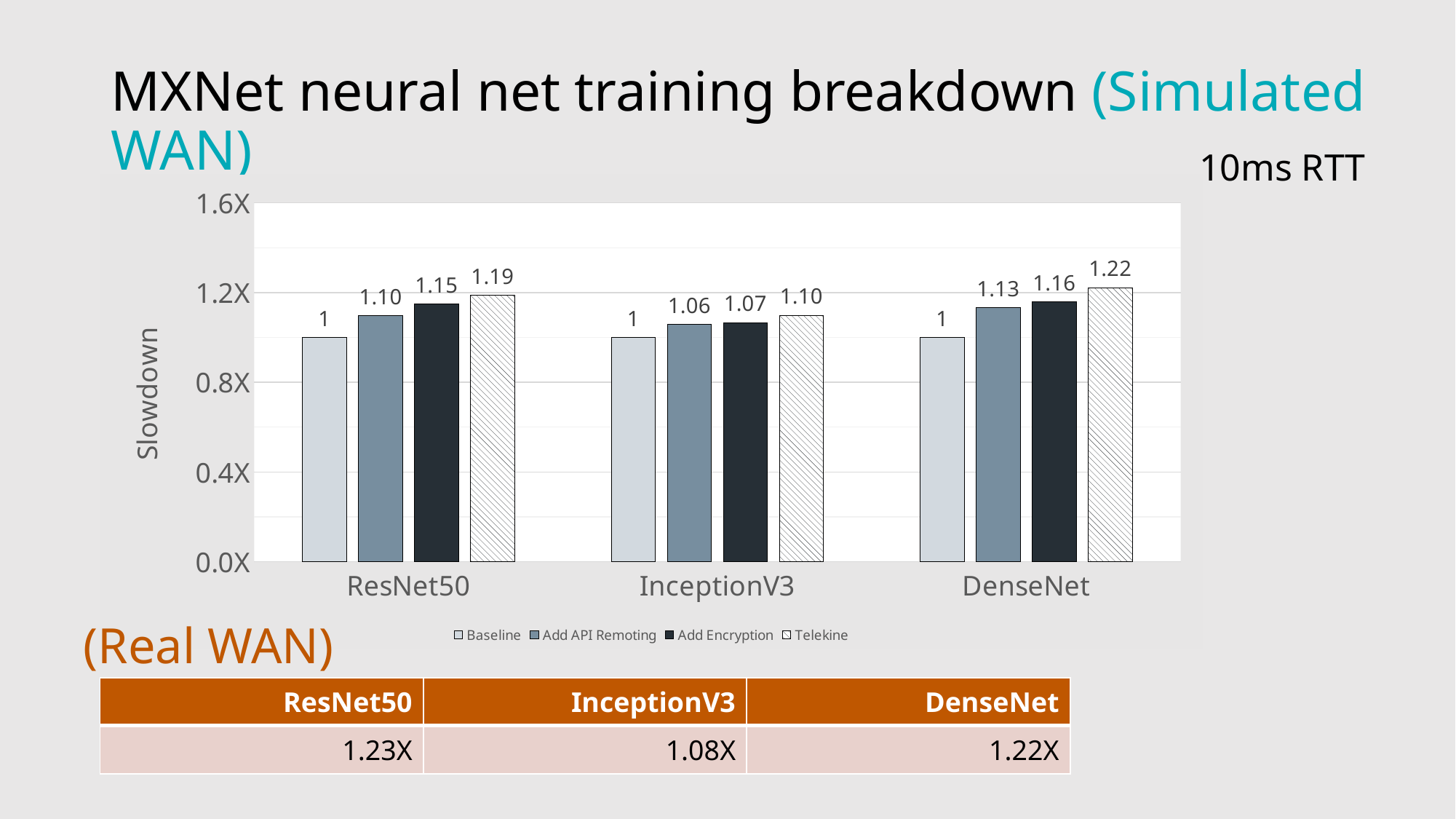
What is the difference between the Telekine and Baseline values for ResNet50? 0.19 What is the label of the y axis? Slowdown How many models are shown on the x axis of the chart? 3 Which is larger: the Add Encryption value for DenseNet or the Add Encryption value for InceptionV3? DenseNet Which model has the lowest Telekine slowdown? InceptionV3 What kind of chart is shown on the slide? Bar chart What is the Add Encryption value for ResNet50? 1.15 Which model has the highest Telekine slowdown? DenseNet How many series does the legend list? 4 Is the Telekine value for DenseNet greater or less than 1.2X? greater What is the Add API Remoting value for InceptionV3? 1.06 What is the Telekine slowdown value for DenseNet? 1.22